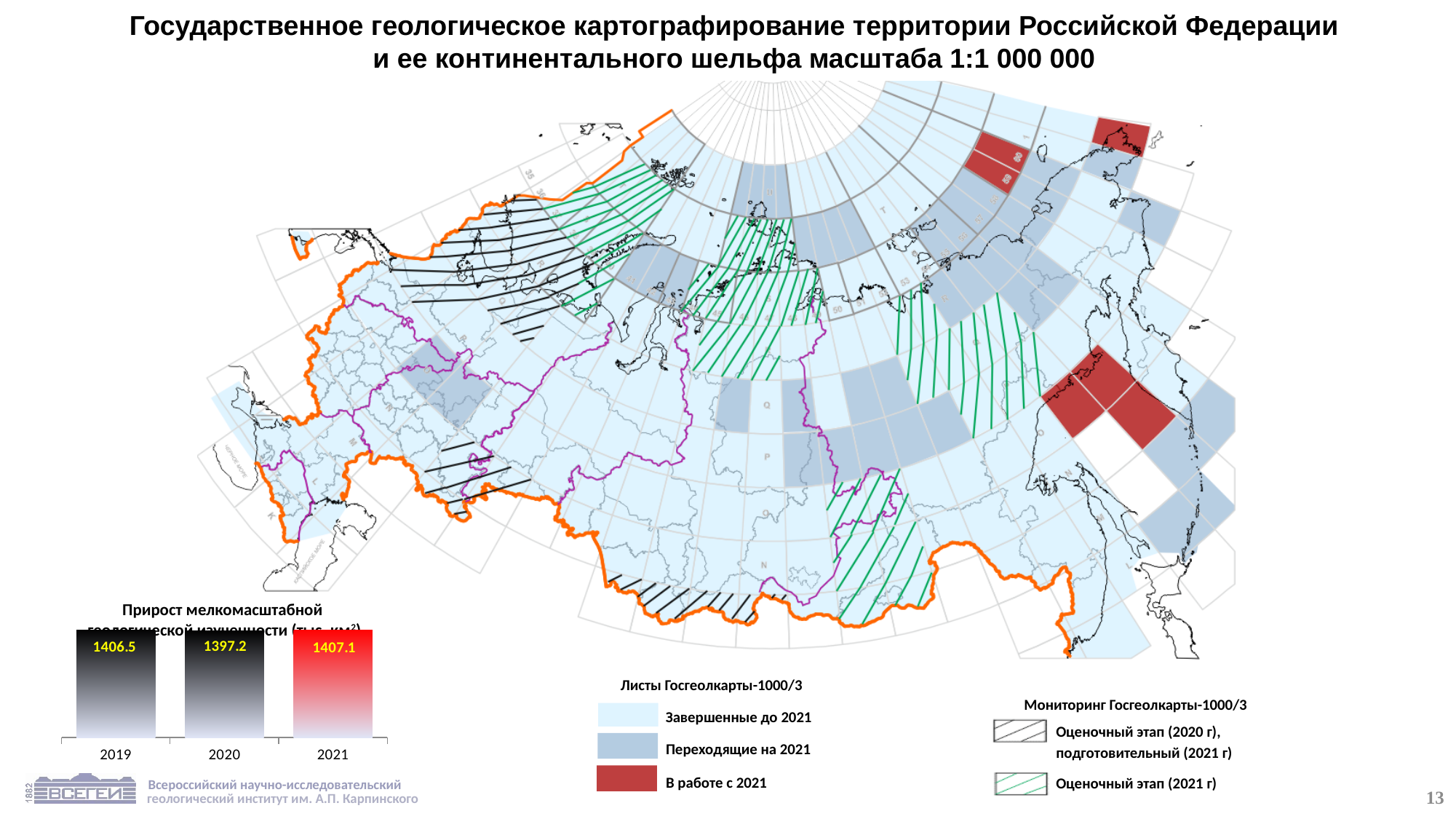
In the bar chart at the bottom left, what is the difference between the values for 2021 and 2020? 9.9 In the bar chart at the bottom left, which year has the highest value? 2021 How many bars are shown in the bar chart at the bottom left? 3 In the bar chart at the bottom left, what is the value for 2020? 1397.2 In the bar chart at the bottom left, what colour is the bar for 2021? red In the bar chart at the bottom left, which is larger, the value for 2020 or the value for 2021? 2021 In the bar chart at the bottom left, what is the value for 2019? 1406.5 In the bar chart at the bottom left, what is the value for 2021? 1407.1 In the bar chart at the bottom left, which year has the lowest value? 2020 In the bar chart at the bottom left, what is the difference between the values for 2019 and 2020? 9.3 What kind of chart is shown at the bottom left of the slide? bar chart In the bar chart at the bottom left, did the value rise or fall from 2019 to 2020? fall